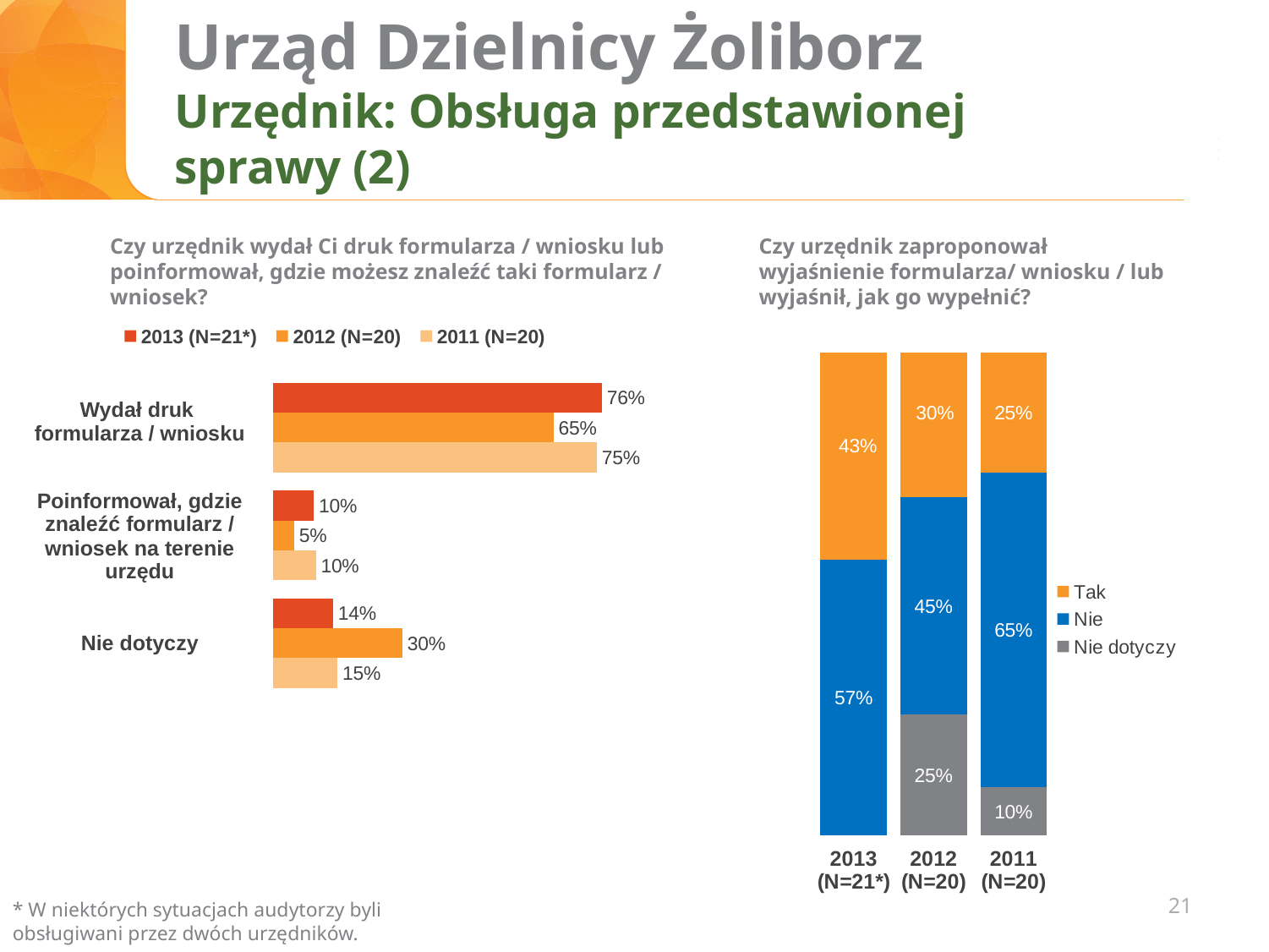
In the right chart, is the "Tak" value larger for 2012 (N=20) or 2011 (N=20)? 2012 (N=20) In the right chart, how many bars (years) are shown? 3 In the right chart, what is the "Nie" value for 2011 (N=20)? 65% In the left chart, what is the 2012 (N=20) value for "Nie dotyczy"? 30% In the left chart, what is the 2013 (N=21*) value for "Wydał druk formularza / wniosku"? 76% In the right chart, which year has the highest "Nie dotyczy" value? 2012 (N=20) In the left chart, what is the difference between the 2013 and 2012 values for "Wydał druk formularza / wniosku"? 11 percentage points In the left chart, how many series does the legend list? 3 In the right chart, what is the "Tak" value for 2013 (N=21*)? 43% In the left chart, what is the 2011 (N=20) value for "Poinformował, gdzie znaleźć formularz / wniosek na terenie urzędu"? 10% In the left chart, which series has the lowest value for "Poinformował, gdzie znaleźć formularz / wniosek na terenie urzędu"? 2012 (N=20) What type of chart is the chart on the left? Bar chart